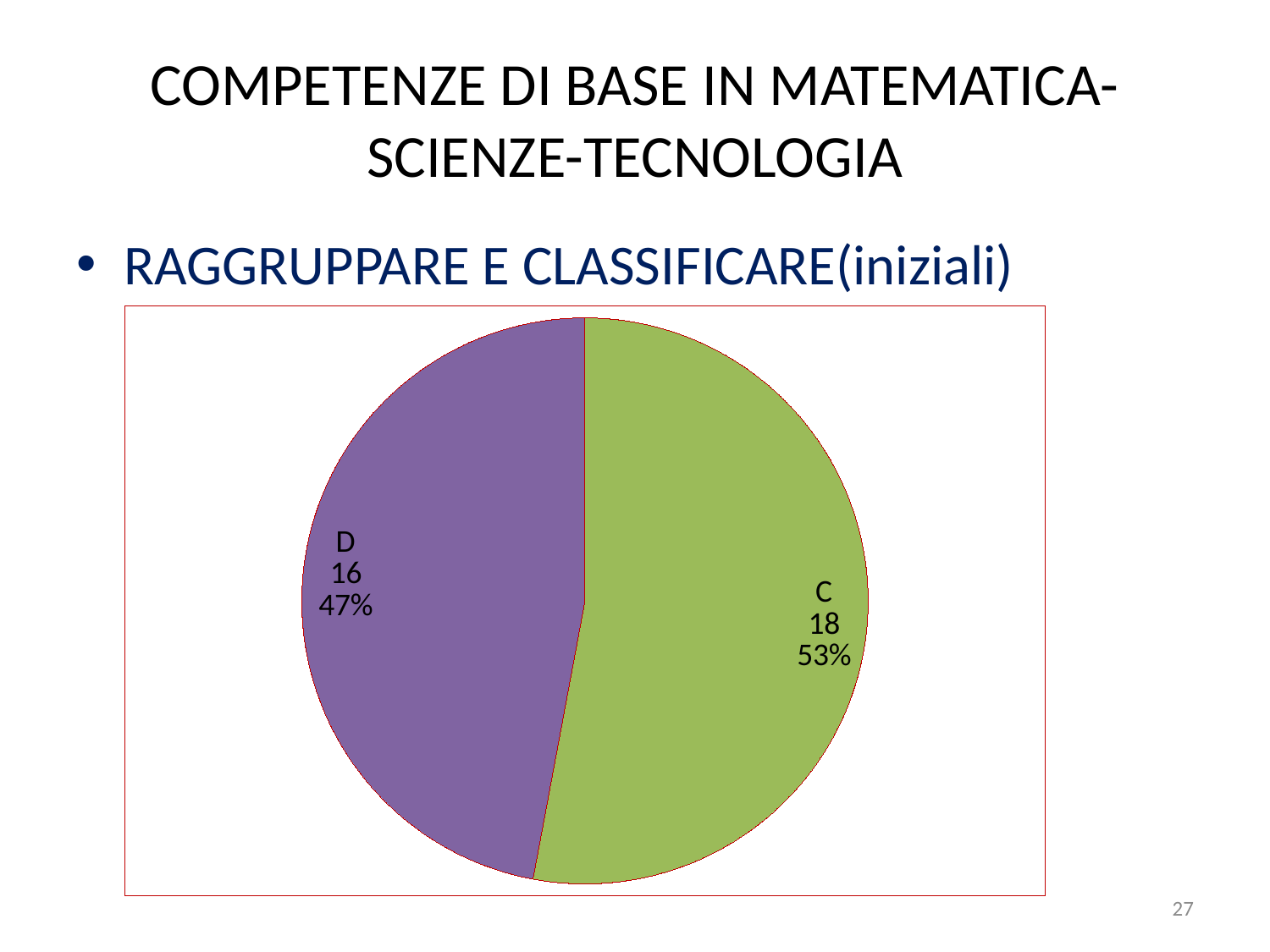
How many slices does the pie chart have? 2 What is the difference between the values of slice C and slice D? 2 What colour is slice D in the pie chart? purple What is the value for slice C? 18 What percentage share does slice D have? 47% What is the total of the values of all slices in the pie chart? 34 Which is larger, slice C or slice D? C What percentage share does slice C have? 53% What is the value for slice D? 16 Which slice is the largest? C Which slice is the smallest? D What kind of chart is shown on the slide? pie chart